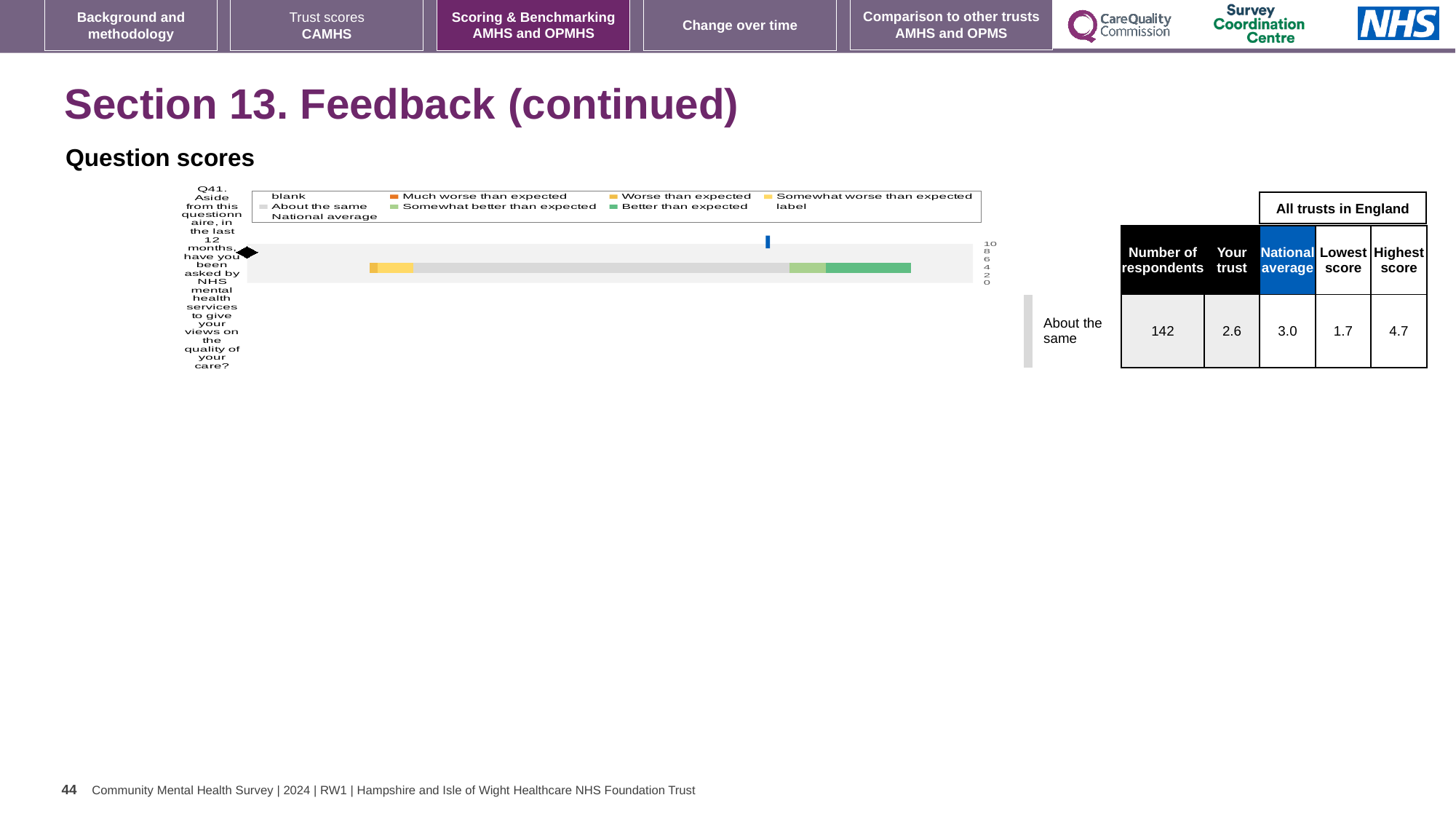
What is the highest score among all trusts in England for Q41? 4.7 What is the difference between the highest and lowest scores for Q41? 3.0 What type of chart is shown under 'Question scores'? bar chart How many respondents answered Q41? 142 What benchmark category is shown for Q41 next to the chart? About the same What is the 'Your trust' score for Q41? 2.6 What is the lowest score among all trusts in England for Q41? 1.7 Which is larger for Q41, the trust's score or the national average? National average How many survey questions are plotted in the chart? 1 Which question number is plotted in the chart? Q41 What is the national average score for Q41? 3.0 By how much does the national average exceed the trust's score for Q41? 0.4